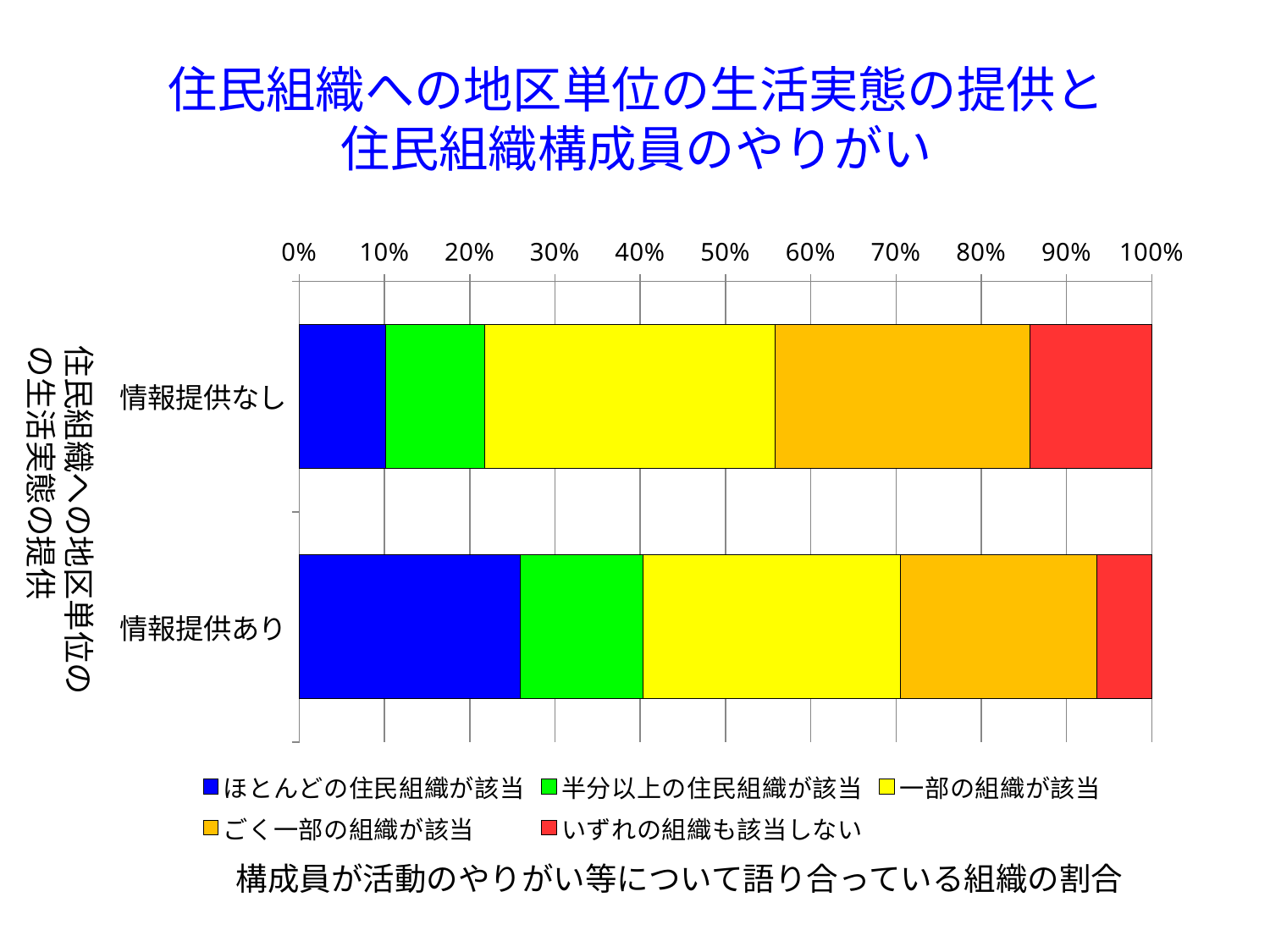
Which colour represents 一部の組織が該当 in the chart? yellow How many categories are plotted on the vertical axis of the chart? 2 How many series does the chart's legend list? 5 What kind of chart is shown on the slide? stacked bar chart Is the value for ほとんどの住民組織が該当 in 情報提供なし greater or less than 20%? less Which series has the smallest segment in the 情報提供あり bar? いずれの組織も該当しない What is the title of the chart on the slide? 住民組織への地区単位の生活実態の提供と住民組織構成員のやりがい Is the value for いずれの組織も該当しない in 情報提供あり greater or less than 10%? less Which category has the larger share for いずれの組織も該当しない, 情報提供なし or 情報提供あり? 情報提供なし Which category has the larger share for ほとんどの住民組織が該当, 情報提供なし or 情報提供あり? 情報提供あり Which category has the larger share for ごく一部の組織が該当, 情報提供なし or 情報提供あり? 情報提供なし Is the value for ほとんどの住民組織が該当 in 情報提供あり greater or less than 20%? greater